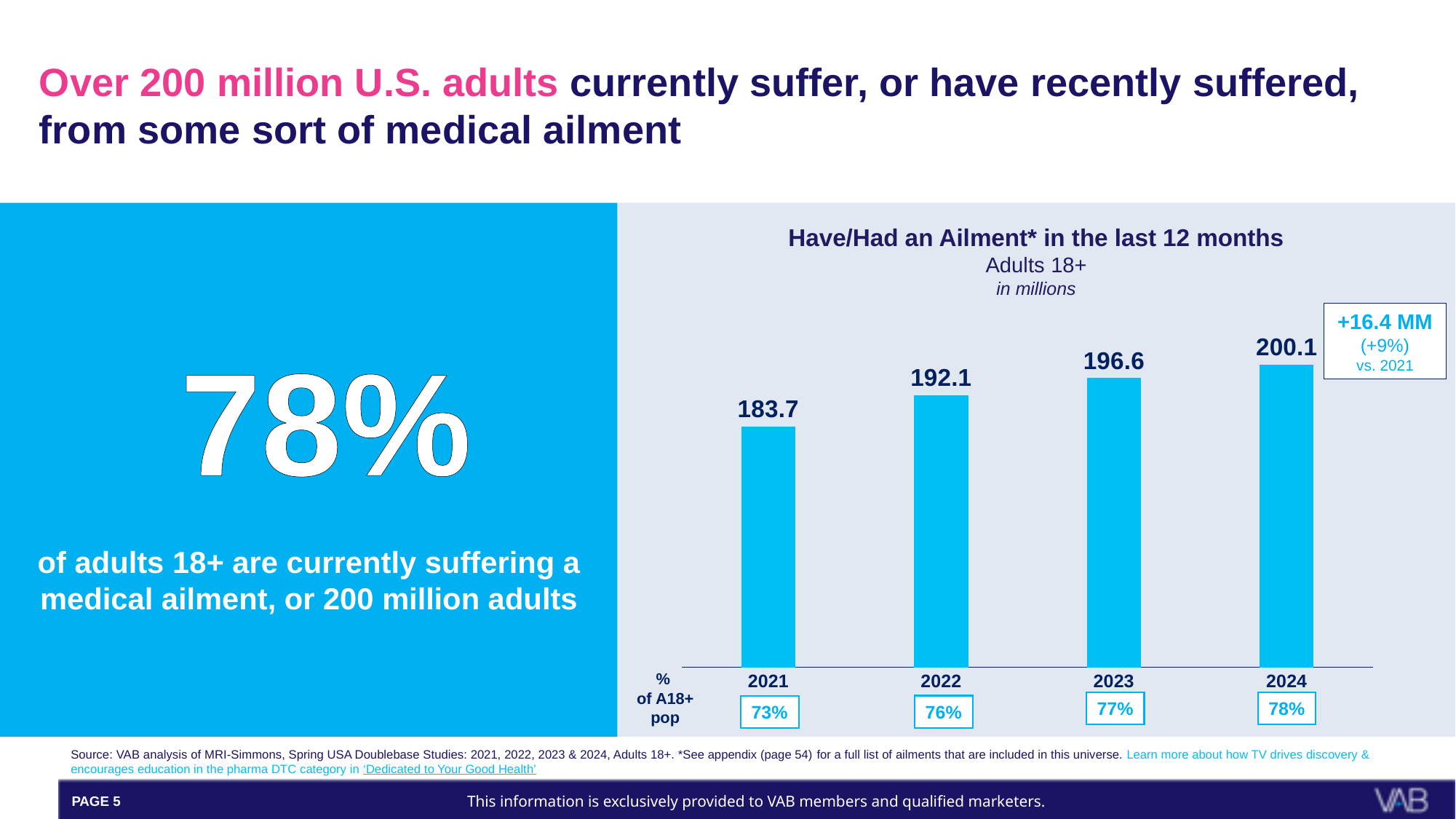
What kind of chart is shown on the slide? Bar chart What is the value for 2024 in the chart? 200.1 Do the values rise or fall from 2021 to 2024 in the chart? Rise What is the value for 2022 in the chart? 192.1 What is the difference between the 2023 and 2022 values in the chart? 4.5 Which is larger in the chart, the value for 2022 or the value for 2023? 2023 Which year has the highest value in the chart? 2024 How many years are shown in the chart? 4 Which year has the lowest value in the chart? 2021 What percentage of the A18+ population is shown below the 2022 bar? 76% What is the difference between the 2024 and 2021 values in the chart? 16.4 What is the value for 2021 in the chart? 183.7